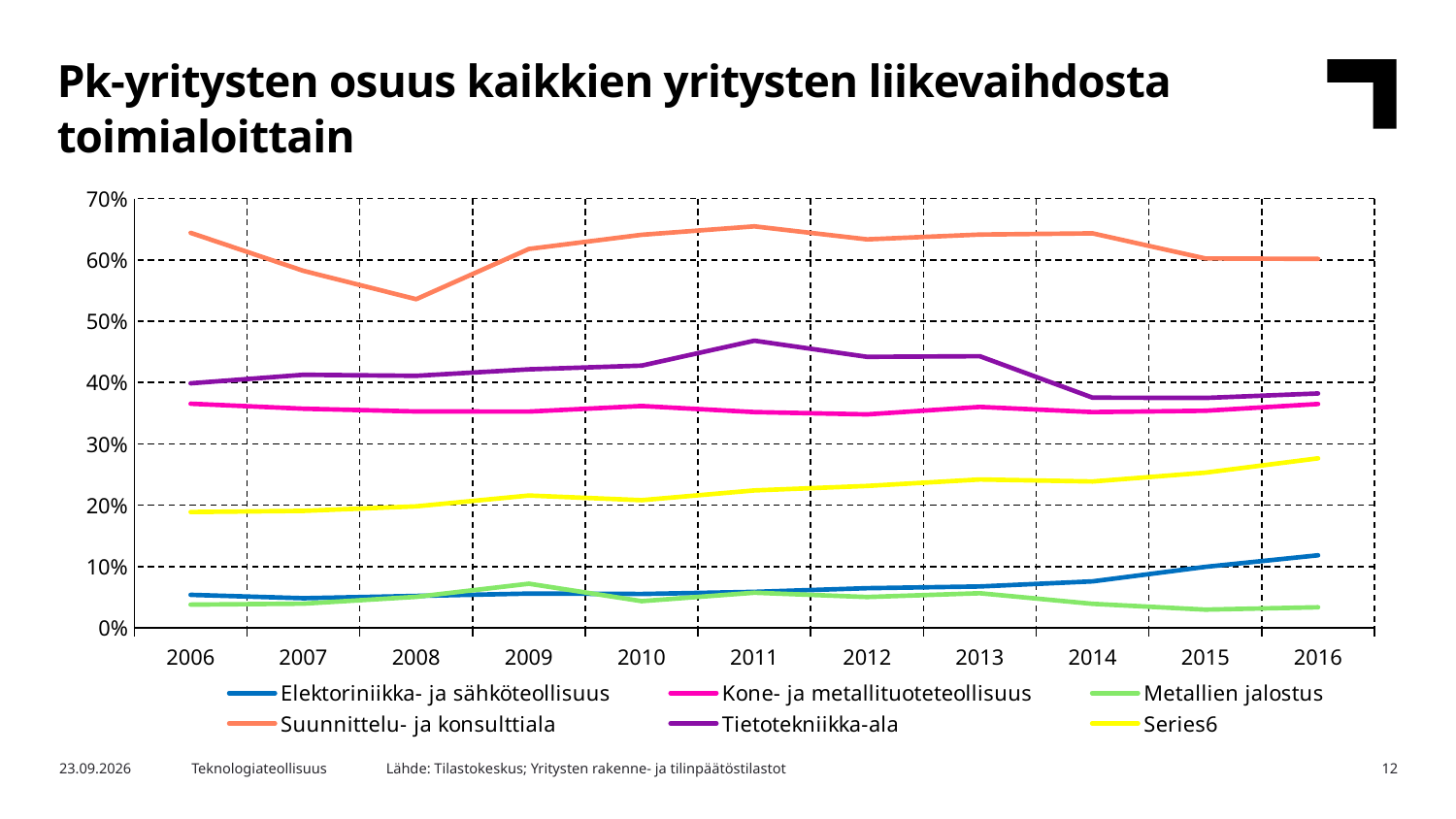
In which year does Tietotekniikka-ala reach its highest value? 2011 Is the value for Suunnittelu- ja konsulttiala in 2008 greater or less than 60%? less Which series has the lowest value in 2016? Metallien jalostus Does the value for Elektoriniikka- ja sähköteollisuus rise or fall from 2006 to 2016? rises How many series does the legend list? 6 Which series has the highest value in 2016? Suunnittelu- ja konsulttiala What type of chart is shown on the slide? line chart Is the value for Elektoriniikka- ja sähköteollisuus in 2016 greater or less than 10%? greater In 2010, which is larger: Tietotekniikka-ala or Kone- ja metallituoteteollisuus? Tietotekniikka-ala Is the value for Tietotekniikka-ala in 2011 greater or less than 40%? greater What is the title of the chart? Pk-yritysten osuus kaikkien yritysten liikevaihdosta toimialoittain How many years are shown on the x axis? 11